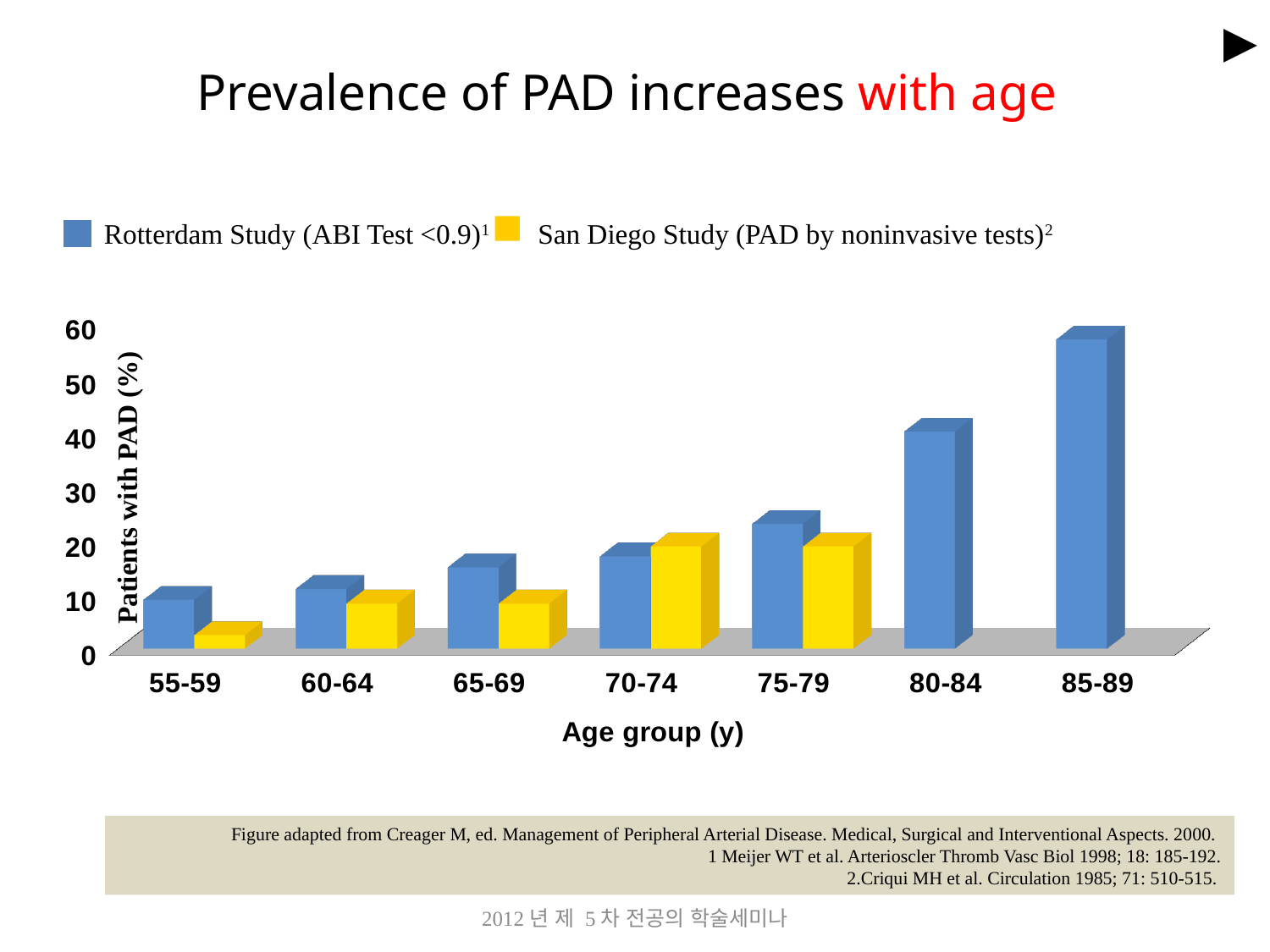
Is the San Diego Study value for the 55-59 age group greater or less than 10? less Which age group has the highest value for the Rotterdam Study? 85-89 Do the Rotterdam Study values rise or fall as age group increases along the x axis? rise Is the Rotterdam Study value for the 80-84 age group greater or less than 30? greater Which is larger for the San Diego Study: the value for 55-59 or the value for 70-74? 70-74 What colour represents the San Diego Study in the legend? yellow How many series does the legend list? 2 How many age groups are shown on the x axis? 7 Which is larger for the Rotterdam Study: the value for 80-84 or the value for 85-89? 85-89 What kind of chart is shown on the slide? bar chart Which age group has the lowest value for the San Diego Study? 55-59 Is the Rotterdam Study value for the 85-89 age group greater or less than 50? greater